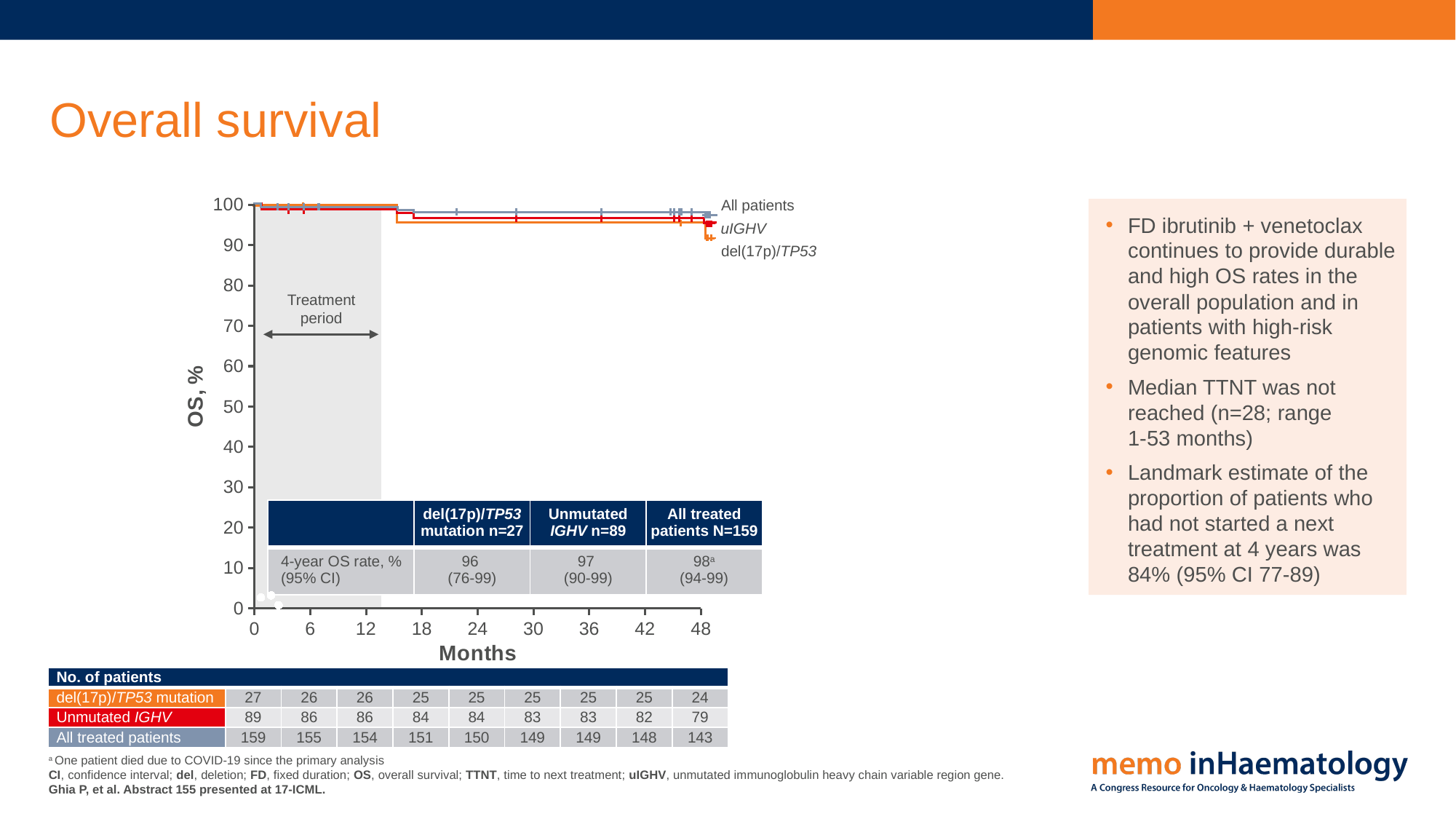
What is the 4-year OS rate for patients with unmutated IGHV? 97 What is the 95% CI for the 4-year OS rate in the del(17p)/TP53 mutation group? (76-99) How many patient groups (curves) are plotted on the overall survival chart? 3 How many patients with unmutated IGHV were at risk at 0 months? 89 How many all treated patients were at risk at 48 months? 143 What is the label of the x axis? Months What is the 4-year OS rate for patients with del(17p)/TP53 mutation? 96 What is the difference in 4-year OS rate between all treated patients and the del(17p)/TP53 mutation group? 2 What kind of chart is shown on the slide? Line chart (Kaplan-Meier survival curve) What is the 4-year OS rate for all treated patients? 98 Which group has the highest 4-year OS rate? All treated patients Is the OS value for the del(17p)/TP53 curve at 48 months greater or less than 80%? greater